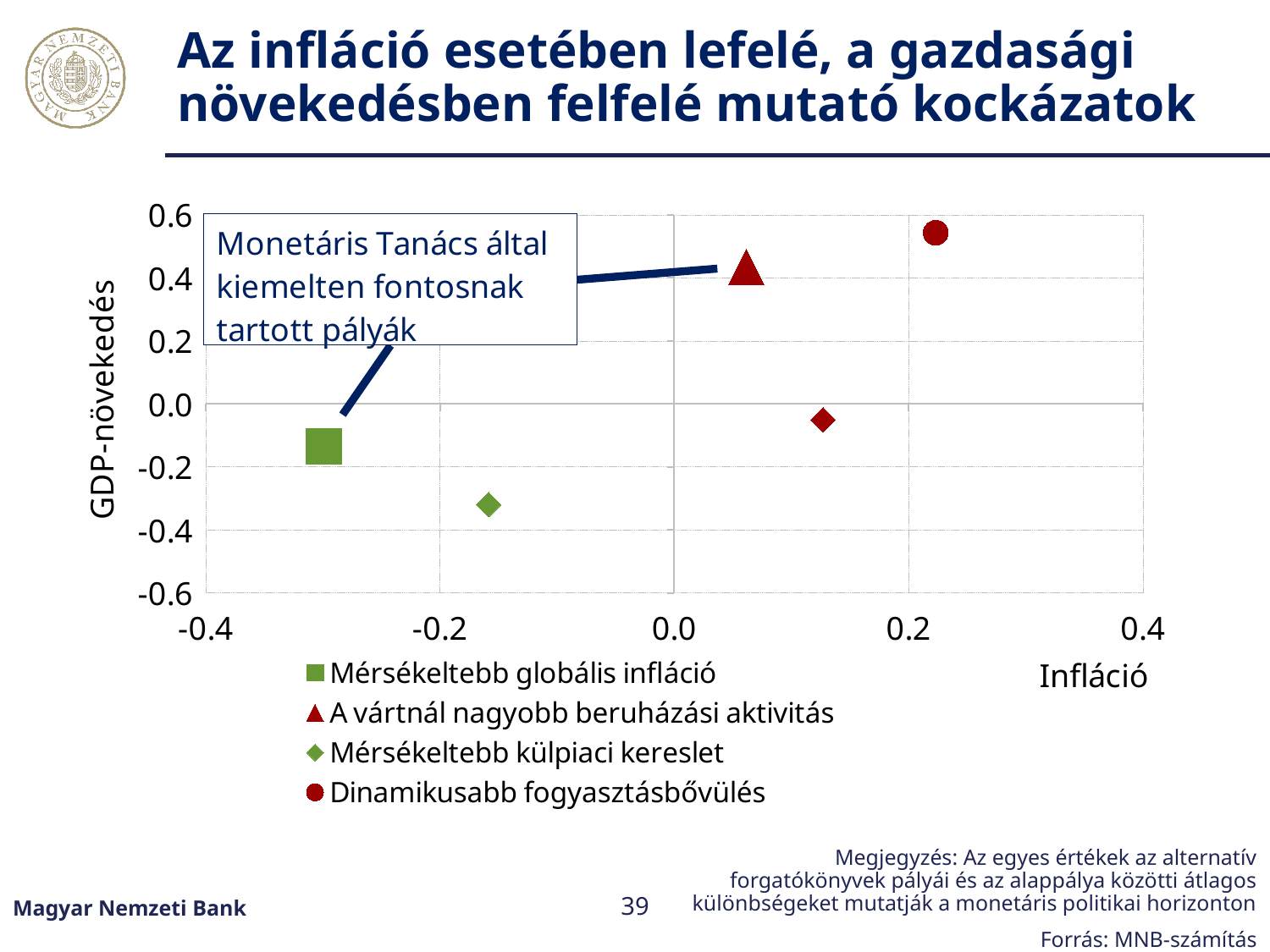
Is the GDP-növekedés value for Dinamikusabb fogyasztásbővülés greater or less than 0.4? greater Which has a higher GDP-növekedés value: A vártnál nagyobb beruházási aktivitás or Mérsékeltebb globális infláció? A vártnál nagyobb beruházási aktivitás How many data points are plotted on the chart? 5 Which series has the lowest Infláció value? Mérsékeltebb globális infláció Which series has the highest GDP-növekedés value? Dinamikusabb fogyasztásbővülés Is the GDP-növekedés value for Mérsékeltebb külpiaci kereslet greater or less than -0.2? less Is the Infláció value for Mérsékeltebb globális infláció greater or less than -0.2? less What kind of chart is shown on the slide? scatter chart Which series has the highest Infláció value? Dinamikusabb fogyasztásbővülés How many series does the legend list? 4 Which series has the lowest GDP-növekedés value? Mérsékeltebb külpiaci kereslet What is the label of the vertical axis? GDP-növekedés